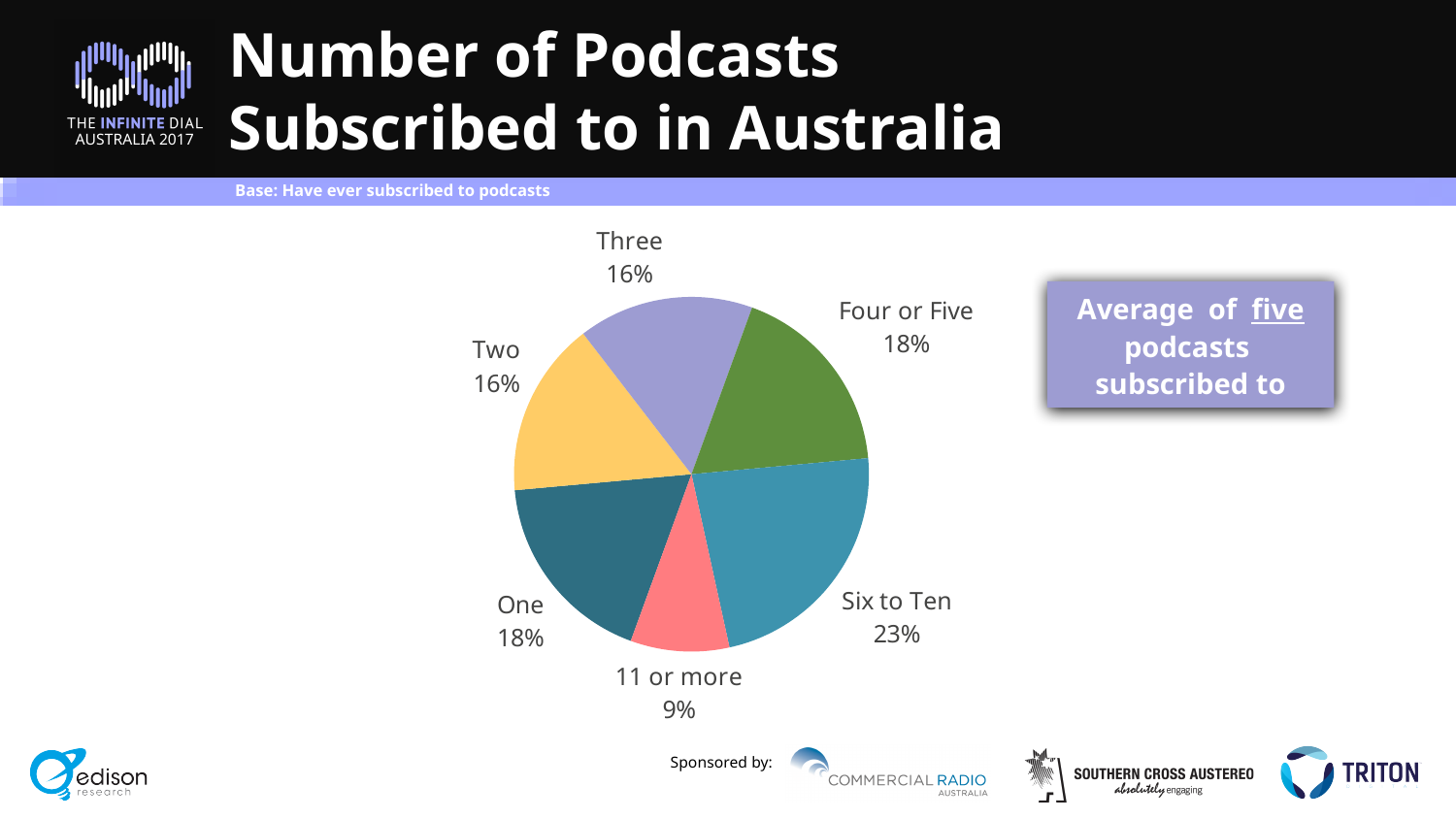
Which category has the largest share of the pie? Six to Ten What is the difference in percentage points between the 'Six to Ten' slice and the '11 or more' slice? 14 Which category has the smallest share of the pie? 11 or more What share of the pie is labelled 'One'? 18% Which is larger, the share for 'Four or Five' or the share for 'Three'? Four or Five What is the base population stated for the chart? Have ever subscribed to podcasts How many slices does the pie chart have? 6 According to the call-out box, what is the average number of podcasts subscribed to? five What is the combined share of the 'Two' and 'Three' slices? 32% What percentage of podcast subscribers in Australia subscribe to Six to Ten podcasts? 23% What percentage subscribe to 11 or more podcasts? 9% What kind of chart is shown on the slide? Pie chart